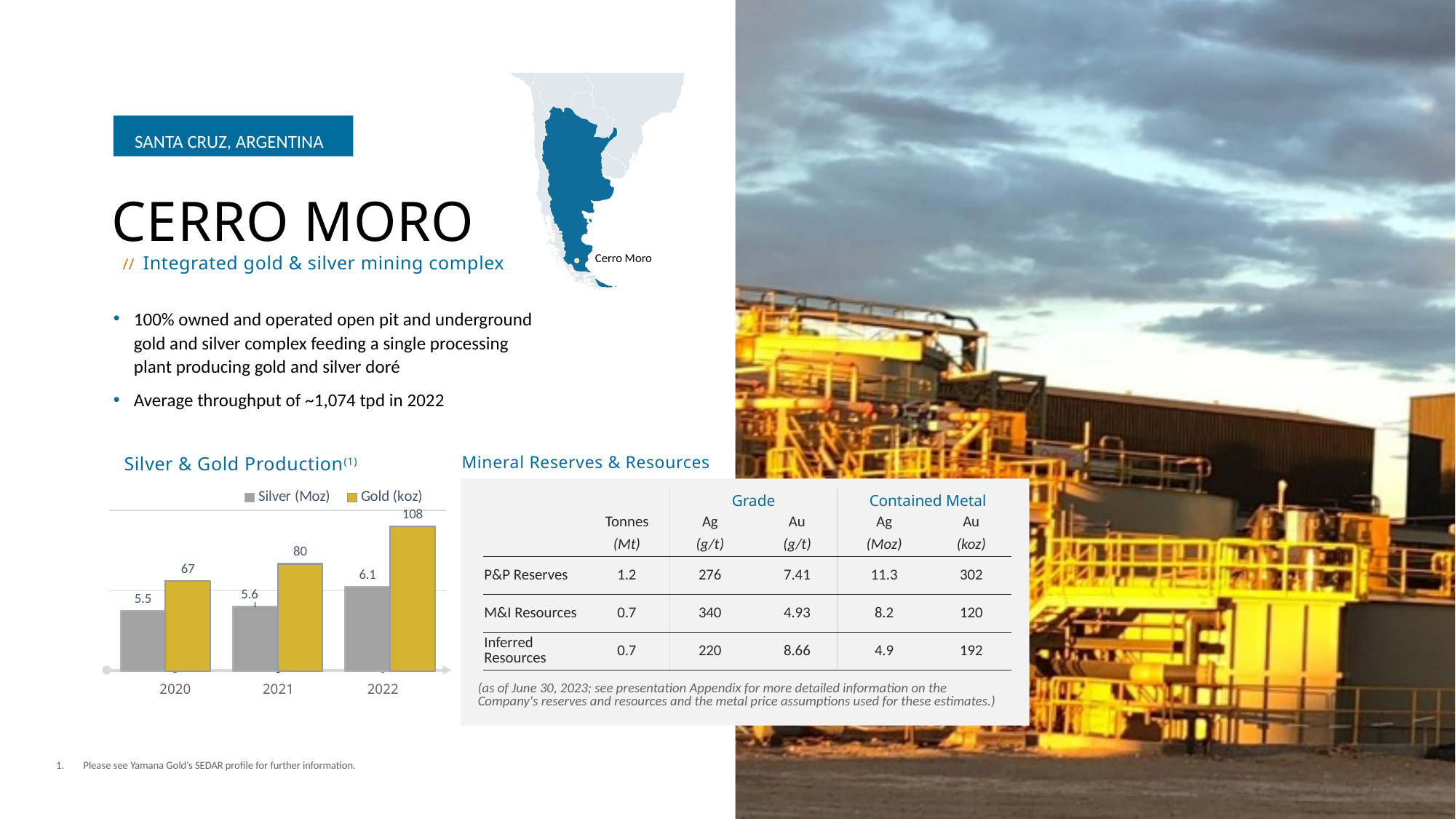
How many series does the legend of the Silver & Gold Production chart list? 2 Which year had higher silver production in the Silver & Gold Production chart, 2020 or 2022? 2022 In which year was silver production lowest in the Silver & Gold Production chart? 2020 What is the difference in gold production (koz) between 2020 and 2021 in the Silver & Gold Production chart? 13 What was the gold production (koz) in 2021 in the Silver & Gold Production chart? 80 What was the silver production (Moz) in 2022 in the Silver & Gold Production chart? 6.1 In which year was gold production highest in the Silver & Gold Production chart? 2022 By how much did gold production (koz) increase from 2021 to 2022 in the Silver & Gold Production chart? 28 What was the gold production (koz) in 2022 in the Silver & Gold Production chart? 108 What type of chart is the Silver & Gold Production chart? Bar chart What was the silver production (Moz) in 2020 in the Silver & Gold Production chart? 5.5 How many years are shown on the x axis of the Silver & Gold Production chart? 3